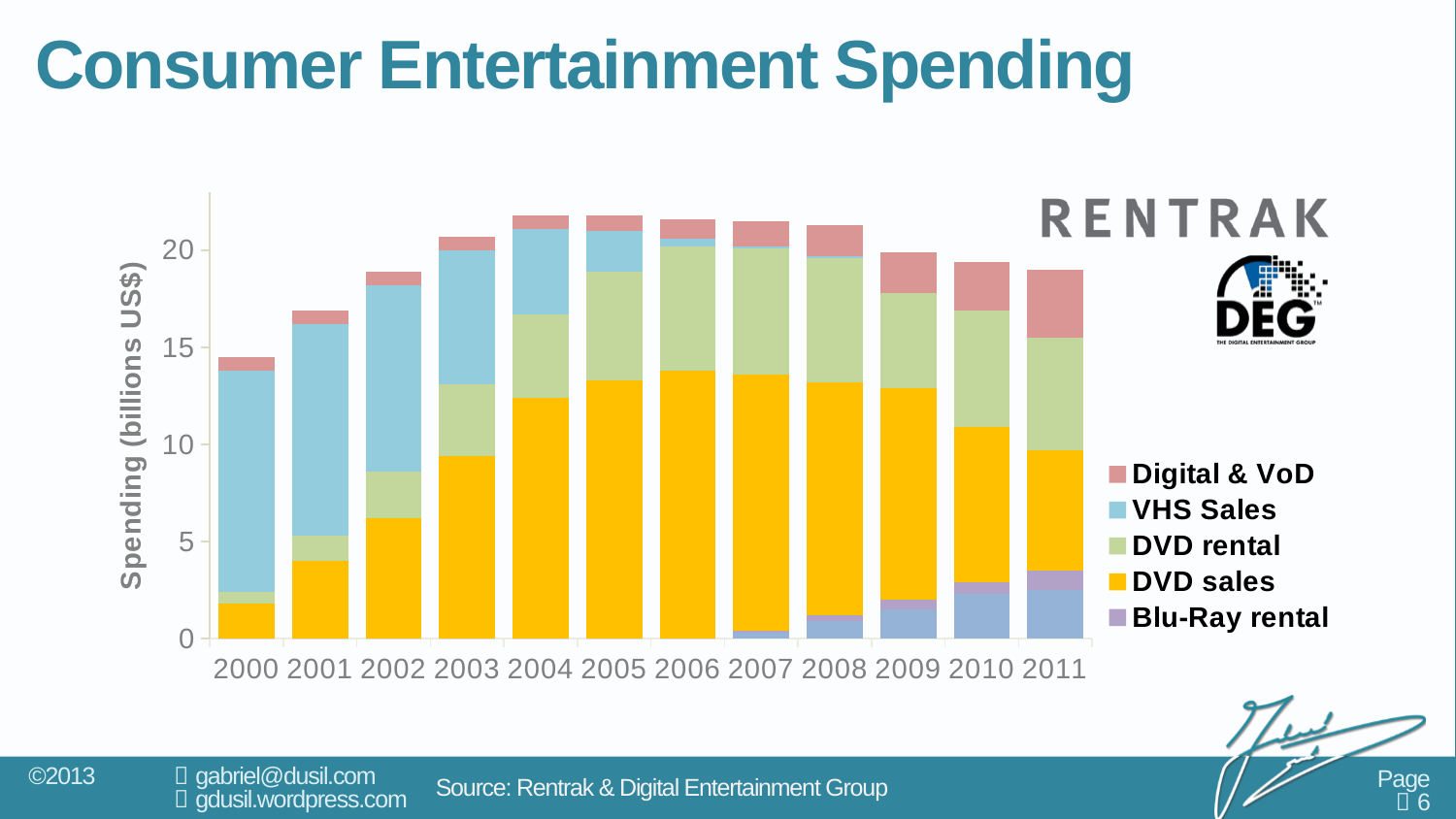
Does total spending rise or fall from 2000 to 2004? rise Is the total spending for 2011 greater or less than 20? less Which year has higher total spending, 2000 or 2001? 2001 What kind of chart is shown on the slide? Stacked bar chart What is the label on the y axis of the chart? Spending (billions US$) Is the total spending for 2000 greater or less than 15? less Which year has higher total spending, 2003 or 2011? 2003 How many years are shown along the x axis of the chart? 12 How many series does the chart's legend list? 5 Does total spending rise or fall from 2006 to 2011? fall Which year has the lowest total consumer entertainment spending? 2000 Is the total spending for 2004 greater or less than 20? greater